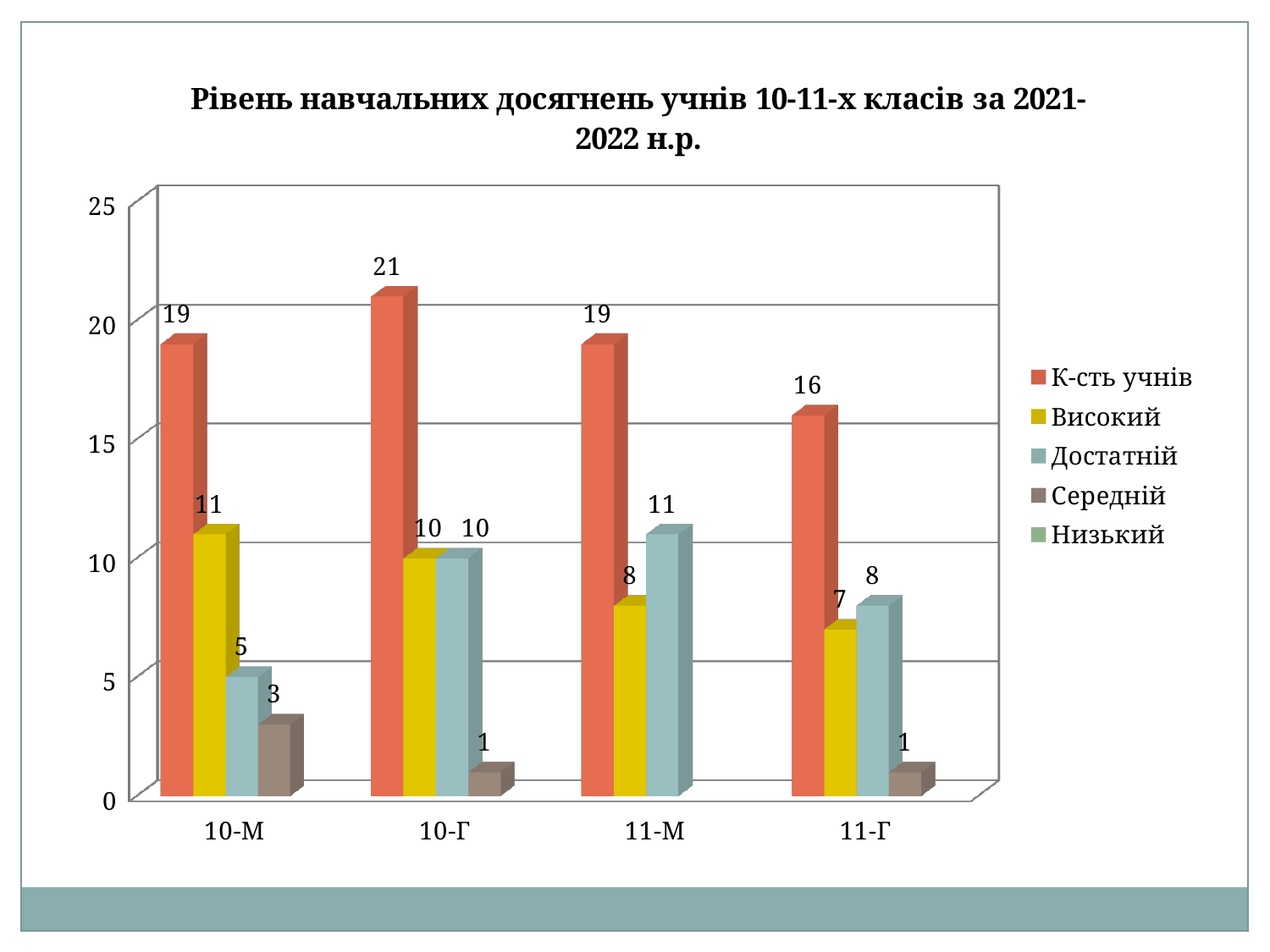
Which class has the highest value for К-сть учнів? 10-Г Which is larger: Високий for 11-М or Достатній for 11-М? Достатній for 11-М What is the difference between Високий for 10-М and Високий for 11-Г? 4 What is the value of Достатній for 11-М? 11 What is the value of Середній for 10-М? 3 How many series does the legend list? 5 Which class has the lowest value for К-сть учнів? 11-Г What is the value of К-сть учнів for 10-Г? 21 What kind of chart is shown on the slide? Bar chart What is the difference between К-сть учнів for 10-Г and for 11-Г? 5 How many classes are shown on the x axis? 4 What is the value of Високий for 10-М? 11